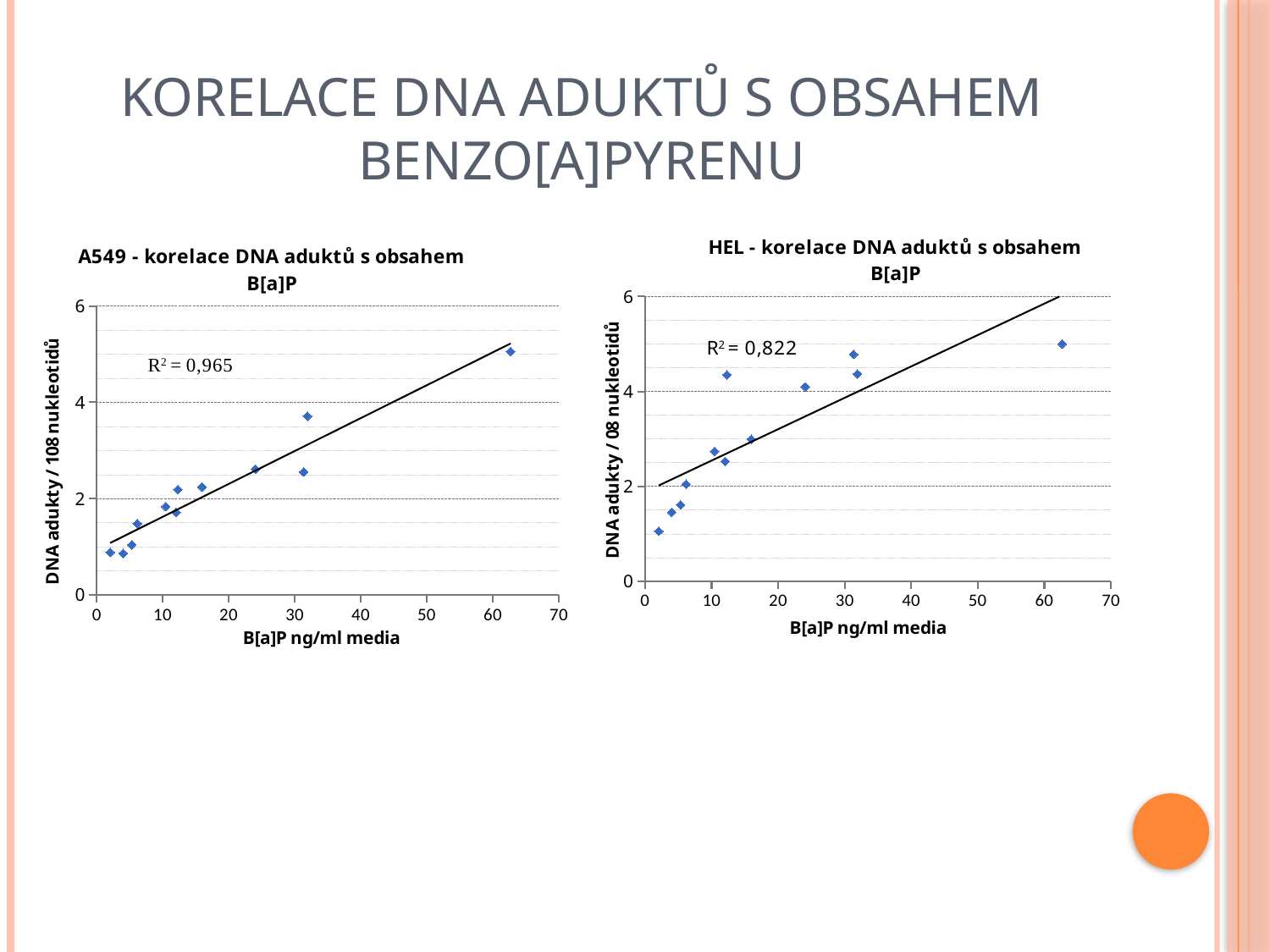
What is the title of the chart on the right? HEL - korelace DNA aduktů s obsahem B[a]P In the HEL chart, what R² value is printed? R² = 0,822 What kind of chart is the HEL chart on the right? scatter chart In the HEL chart, is the value of the rightmost point (near 63 ng/ml) greater or less than 4? greater In the A549 chart, is the value of the rightmost point (near 63 ng/ml) greater or less than 4? greater In the A549 chart, what R² value is printed? R² = 0,965 In the A549 chart, do the DNA adduct values rise or fall as B[a]P concentration increases along the x axis? rise In the HEL chart, is the value of the leftmost point (near 2 ng/ml) greater or less than 2? less In the HEL chart, do the DNA adduct values rise or fall as B[a]P concentration increases along the x axis? rise What is the x-axis label of the A549 chart? B[a]P ng/ml media Which chart shows the higher R² value, A549 or HEL? A549 What kind of chart is the A549 chart on the left? scatter chart